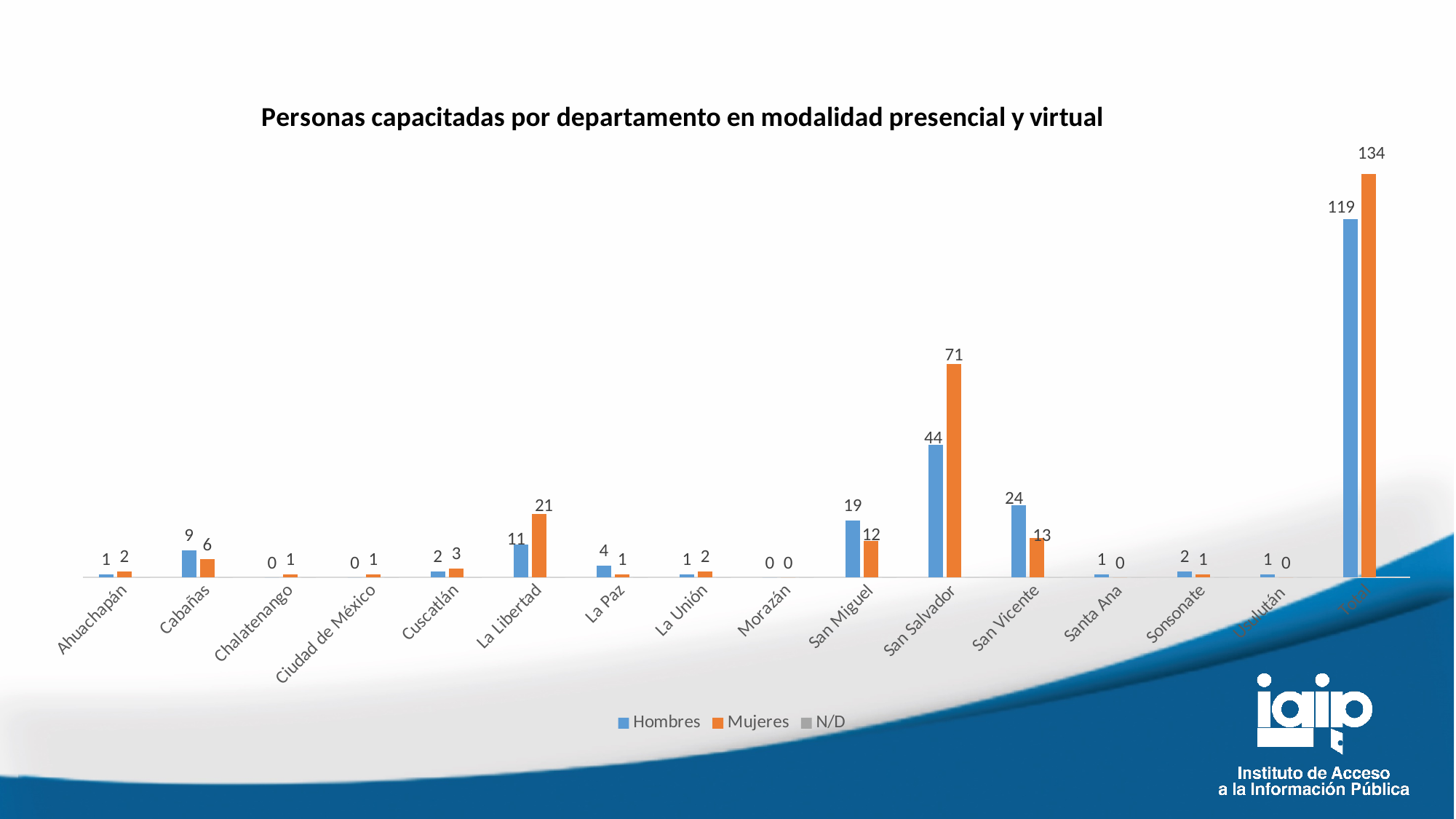
What is the value for Hombres in the Total category? 119 What is the value for Hombres in San Miguel? 19 What is the title of the chart? Personas capacitadas por departamento en modalidad presencial y virtual What kind of chart is shown on the slide? Bar chart What is the difference between Mujeres and Hombres in San Salvador? 27 How many series does the legend list? 3 What is the value for Mujeres in San Salvador? 71 What is the difference between Mujeres and Hombres in the Total category? 15 What is the value for Mujeres in La Libertad? 21 How many categories are shown on the x axis? 16 Which is larger in San Vicente, Hombres or Mujeres? Hombres Excluding the Total category, which department has the highest value for Hombres? San Salvador